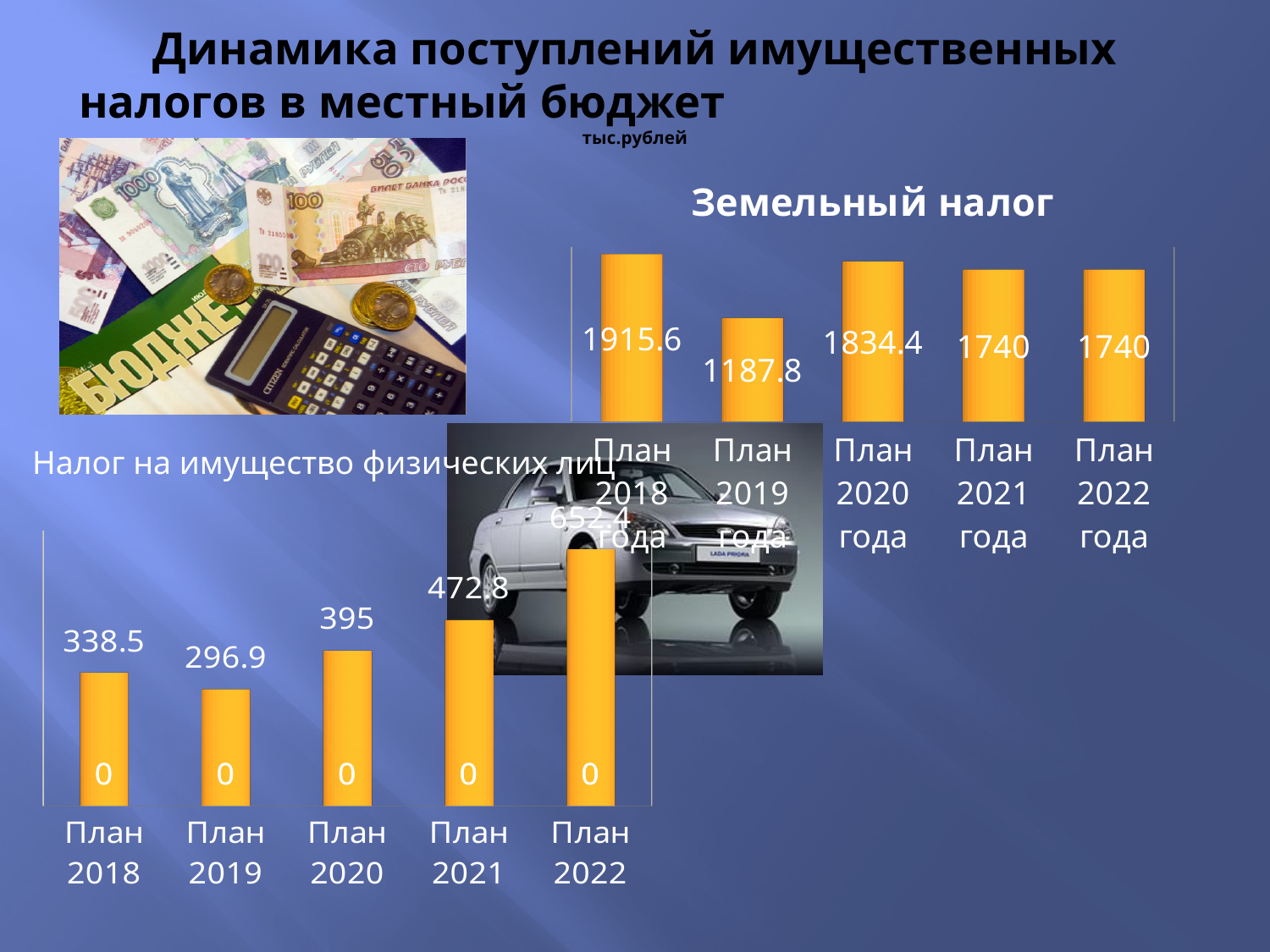
In the 'Земельный налог' chart, which category has the lowest value? План 2019 года In the 'Земельный налог' chart, what is the value for План 2019 года? 1187.8 In the 'Земельный налог' chart, which category has the highest value? План 2018 года In the 'Налог на имущество физических лиц' chart, which is larger: the value for План 2018 or the value for План 2021? План 2021 In the 'Земельный налог' chart, what is the value for План 2018 года? 1915.6 In the 'Налог на имущество физических лиц' chart, what is the value for План 2022? 652.4 In the 'Налог на имущество физических лиц' chart, what is the value for План 2020? 395 In the 'Земельный налог' chart, what is the difference between the values for План 2018 года and План 2020 года? 81.2 What kind of chart is the 'Земельный налог' chart? Bar chart In the 'Налог на имущество физических лиц' chart, what is the difference between the values for План 2022 and План 2021? 179.6 In the 'Земельный налог' chart, how many categories are shown on the x axis? 5 In the 'Налог на имущество физических лиц' chart, which category has the lowest value? План 2019